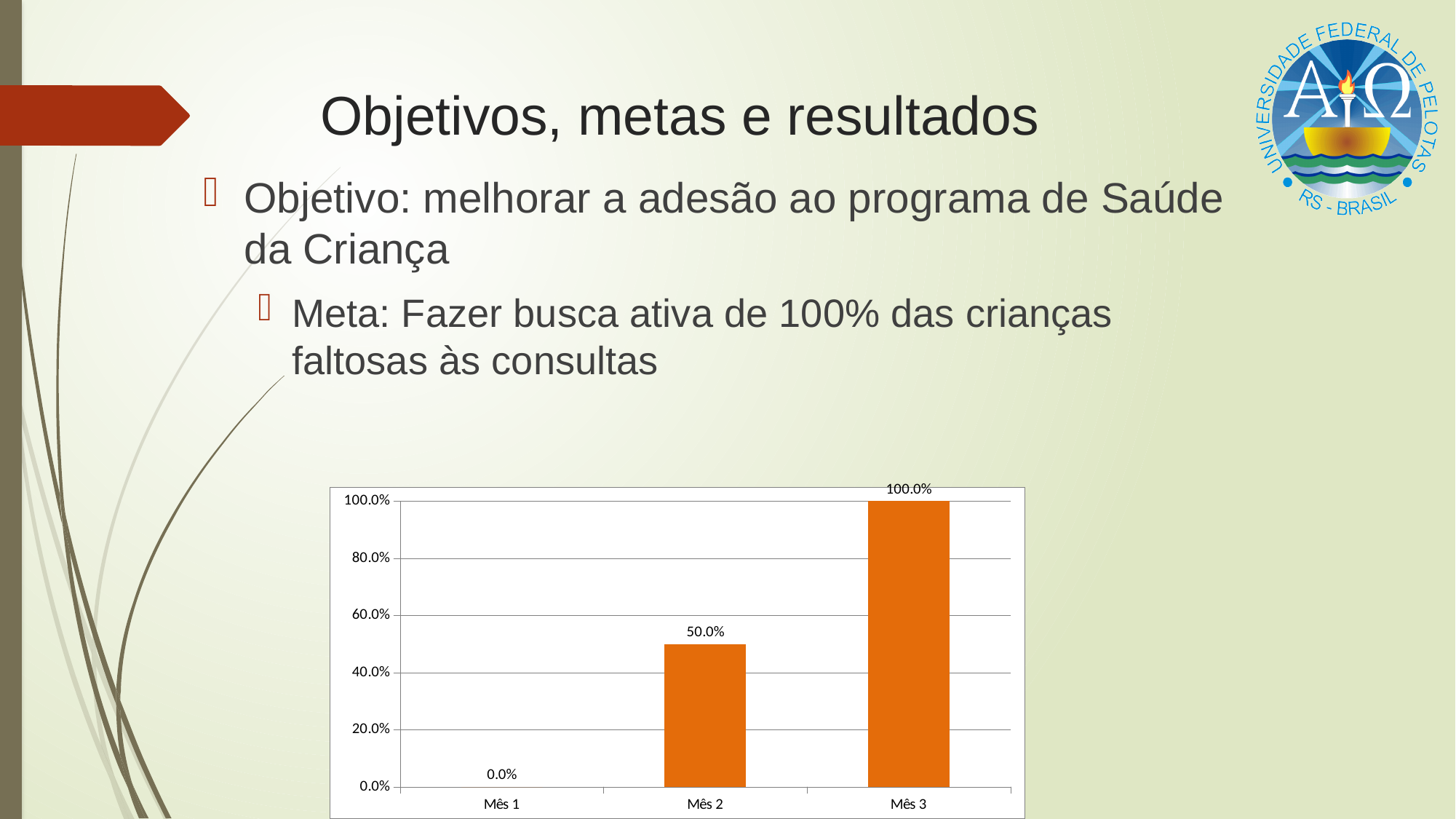
What is the value for Mês 1? 0.0% Do the values rise or fall from Mês 1 to Mês 3? rise Which month has the lowest value? Mês 1 Which is larger, the value for Mês 2 or the value for Mês 3? Mês 3 Is the value for Mês 2 greater or less than 40.0%? greater What is the value for Mês 3? 100.0% What is the value for Mês 2? 50.0% What is the difference between the values for Mês 3 and Mês 2? 50.0% What kind of chart is shown on the slide? bar chart Which month has the highest value? Mês 3 How many categories are shown on the x axis? 3 What colour are the bars in the chart? orange